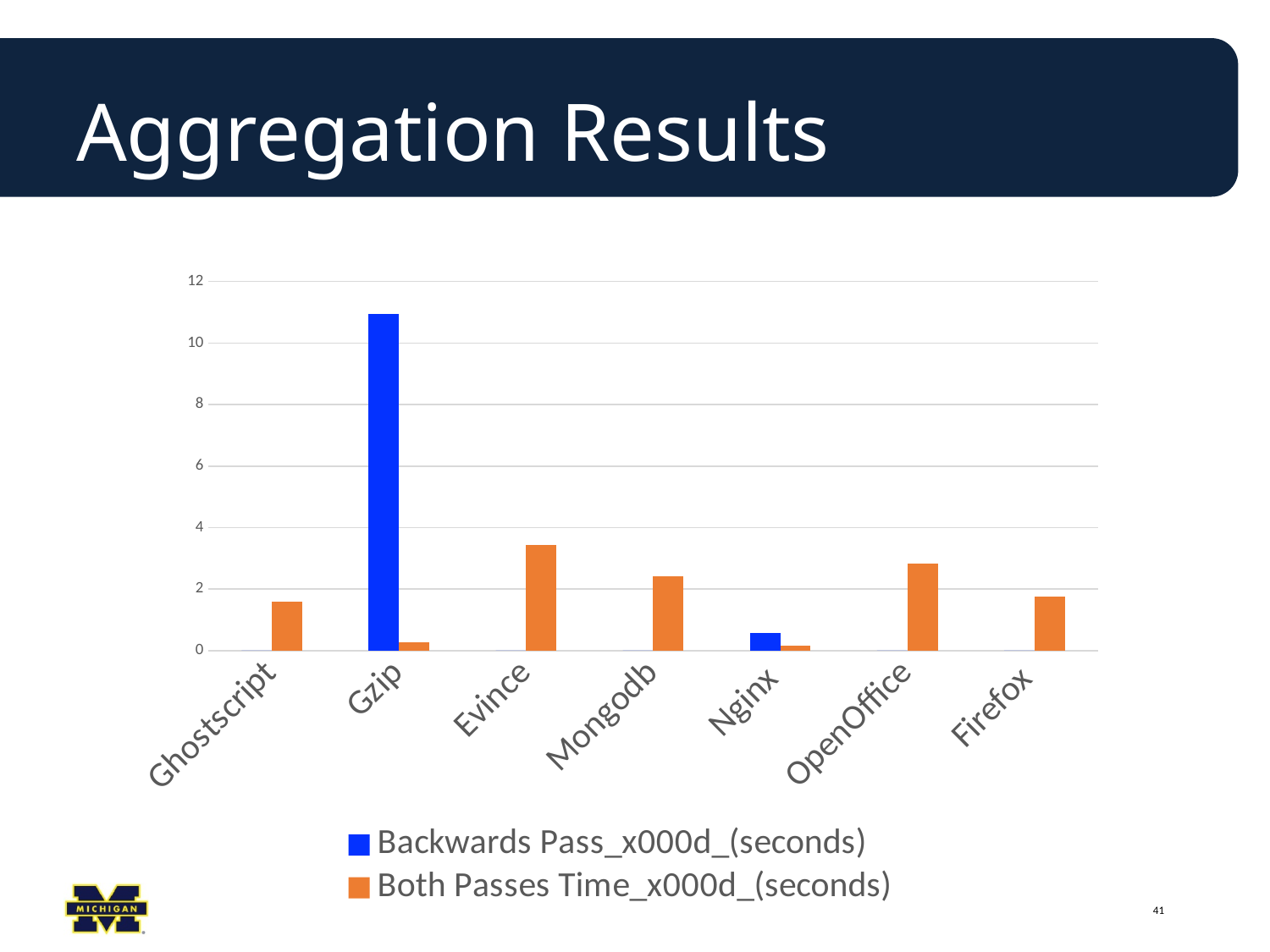
Is the Both Passes Time value for Evince greater or less than 4? less What colour represents the Both Passes Time series in the legend? orange Which is larger: the Both Passes Time value for Evince or for Mongodb? Evince Is the Both Passes Time value for OpenOffice greater or less than 2? greater What kind of chart is shown on the slide? bar chart Which category has the highest Both Passes Time (seconds) value? Evince Which category has the highest Backwards Pass (seconds) value? Gzip How many categories are shown along the x axis? 7 Is the Both Passes Time value for Firefox greater or less than 2? less How many series does the legend list? 2 For Gzip, which is larger: the Backwards Pass value or the Both Passes Time value? Backwards Pass